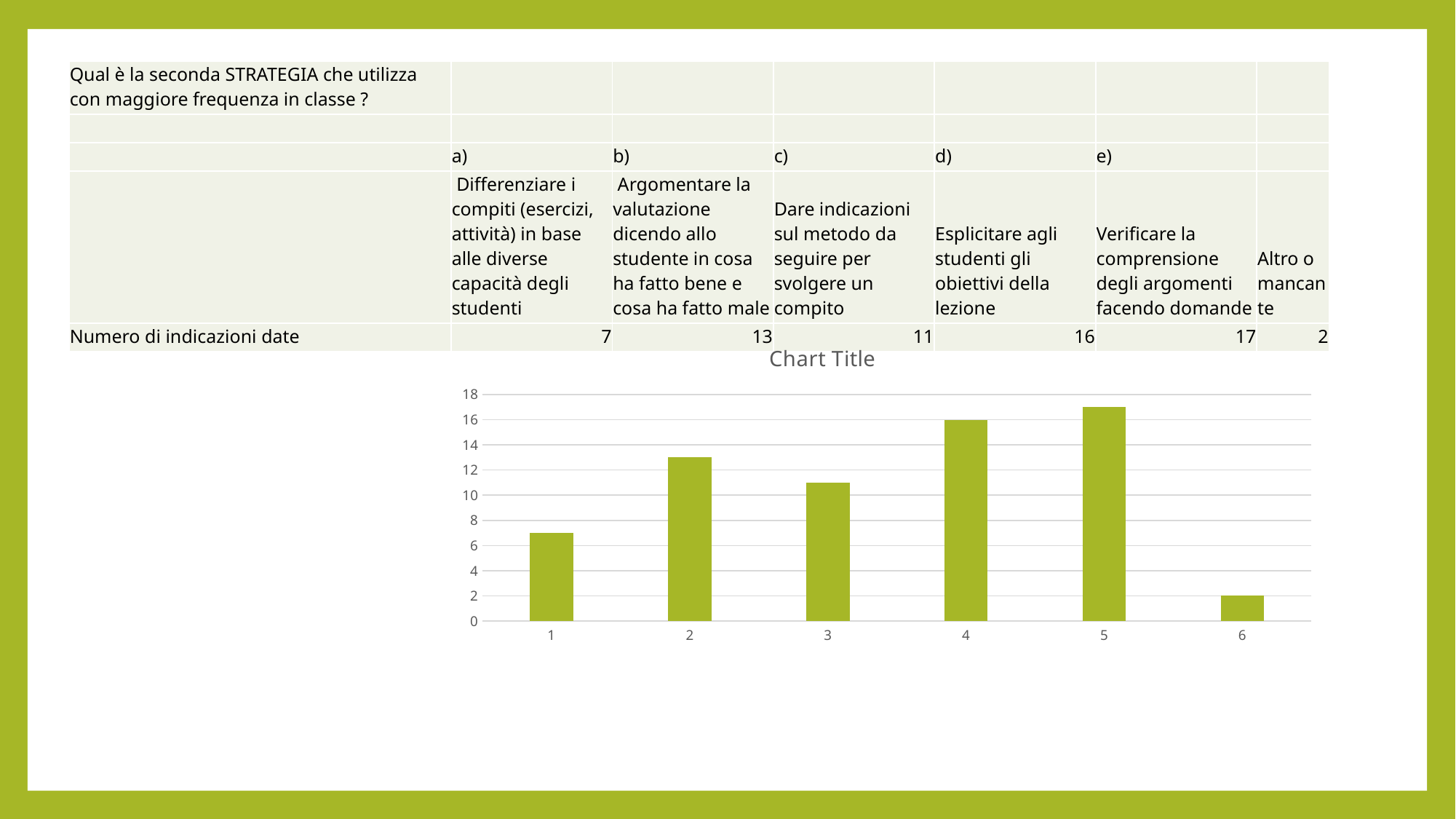
Is the value for category 4 greater or less than 14? greater Which category has the highest bar? 5 What kind of chart is shown on the slide? bar chart What is the highest value shown on the vertical axis? 18 What is the value of the bar for category 6? 2 What is the value of the bar for category 5? 17 What is the title shown above the chart? Chart Title How many bars does the chart have? 6 Which is larger, the bar for category 2 or the bar for category 3? category 2 What is the difference between the values for category 4 and category 3? 5 What is the value of the bar for category 1? 7 Which category has the lowest bar? 6